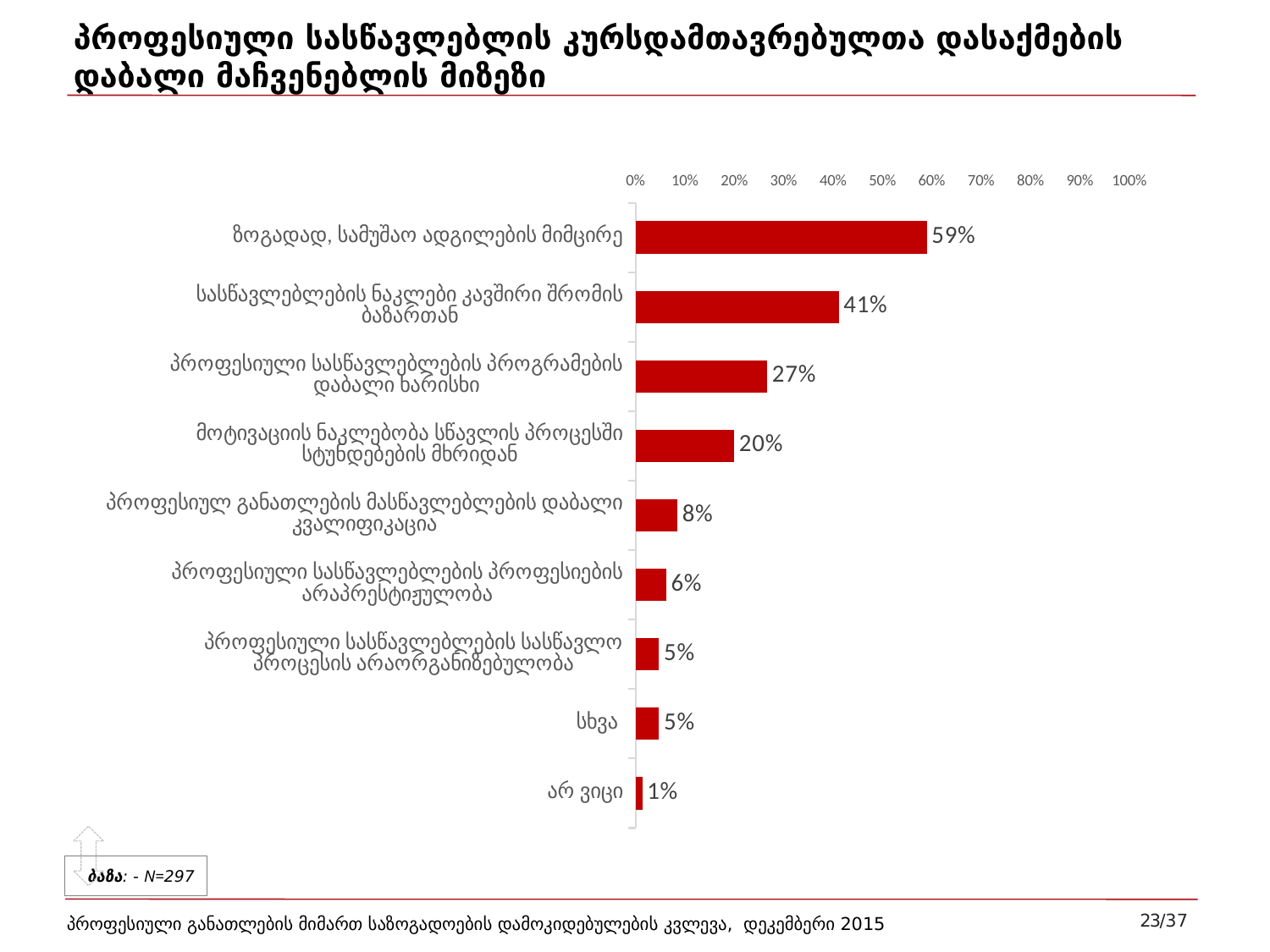
How many categories are shown in the chart? 9 Which category has the lowest value? არ ვიცი What sample size (N) is stated in the base note on the slide? N=297 What is the value for "სასწავლებლების ნაკლები კავშირი შრომის ბაზართან"? 41% What kind of chart is shown on the slide? bar chart Which category has the highest value? ზოგადად, სამუშაო ადგილების მიმცირე What is the value for "მოტივაციის ნაკლებობა სწავლის პროცესში სტუდენტების მხრიდან"? 20% Which is larger: the value for "პროფესიული სასწავლებლების პროგრამების დაბალი ხარისხი" or the value for "მოტივაციის ნაკლებობა სწავლის პროცესში სტუდენტების მხრიდან"? პროფესიული სასწავლებლების პროგრამების დაბალი ხარისხი What is the value for "სხვა"? 5% What is the difference between the values for "ზოგადად, სამუშაო ადგილების მიმცირე" and "სასწავლებლების ნაკლები კავშირი შრომის ბაზართან"? 18% Is the value for "ზოგადად, სამუშაო ადგილების მიმცირე" greater or less than 50%? greater What is the value for "ზოგადად, სამუშაო ადგილების მიმცირე"? 59%